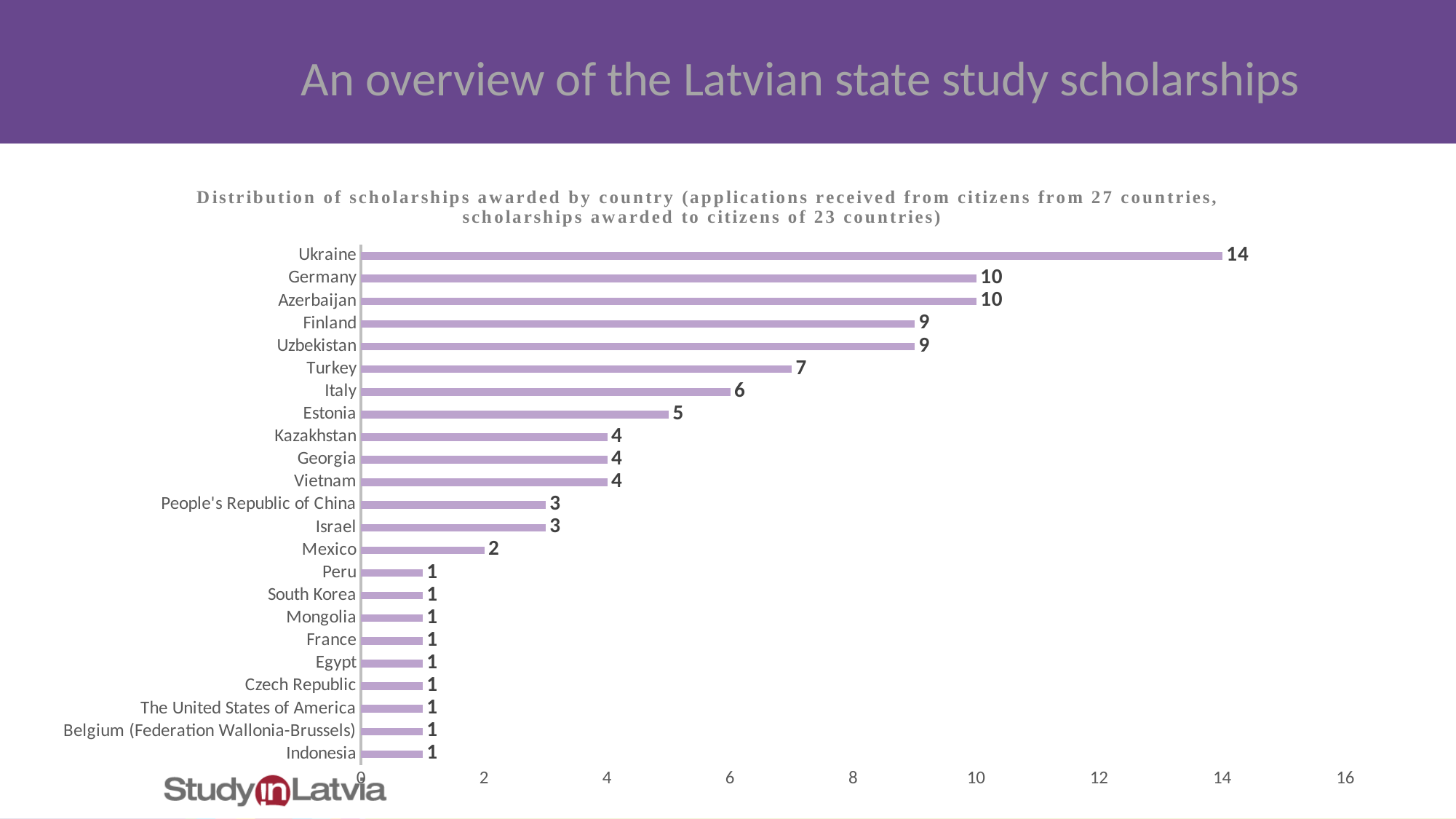
How many countries are listed in the chart? 23 What is the difference between the values for Ukraine and Germany? 4 Which is larger, the value for Estonia or the value for Israel? Estonia Which is larger, the value for Finland or the value for Turkey? Finland What is the value shown for Turkey? 7 What is the value shown for Estonia? 5 What is the highest value shown on the horizontal axis? 16 Which country has the highest number of scholarships awarded? Ukraine How many scholarships were awarded to citizens of Ukraine? 14 What is the value shown for People's Republic of China? 3 What kind of chart is shown on the slide? Bar chart What is the difference between the values for Italy and Mexico? 4